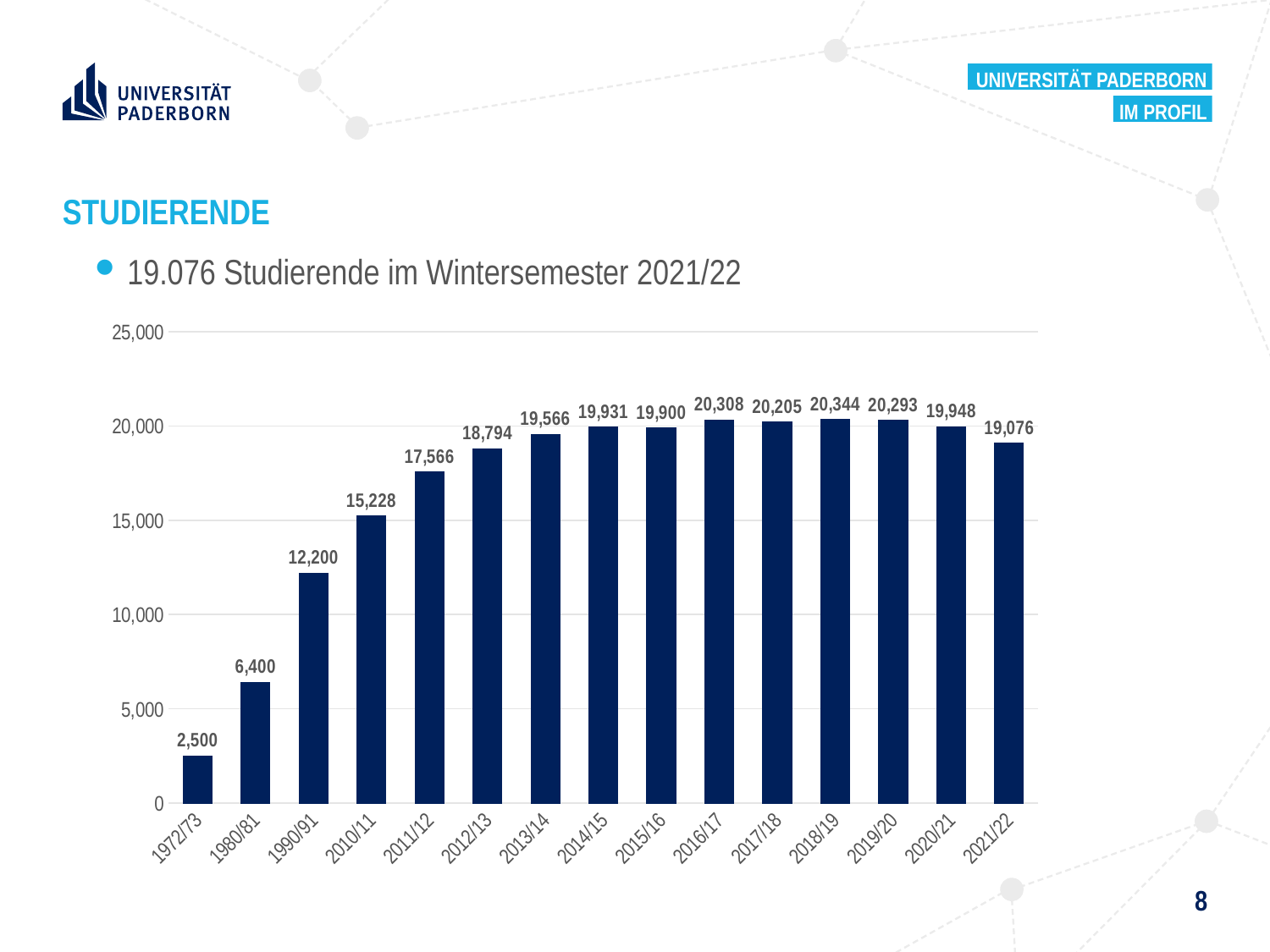
Which semester has the highest number of students? 2018/19 Which is larger, the value for 2011/12 or the value for 2012/13? 2012/13 How many semesters are shown on the x axis? 15 Which semester has the lowest number of students? 1972/73 Is the value for 1990/91 greater or less than 10,000? greater How many students are shown for the winter semester 2021/22? 19,076 Do the values rise or fall from 1972/73 to 2010/11? rise What is the difference between the values for 2020/21 and 2021/22? 872 What is the value for 1990/91? 12,200 What is the value for 2016/17? 20,308 What kind of chart is shown on the slide? bar chart What is the difference between the values for 1980/81 and 1972/73? 3,900